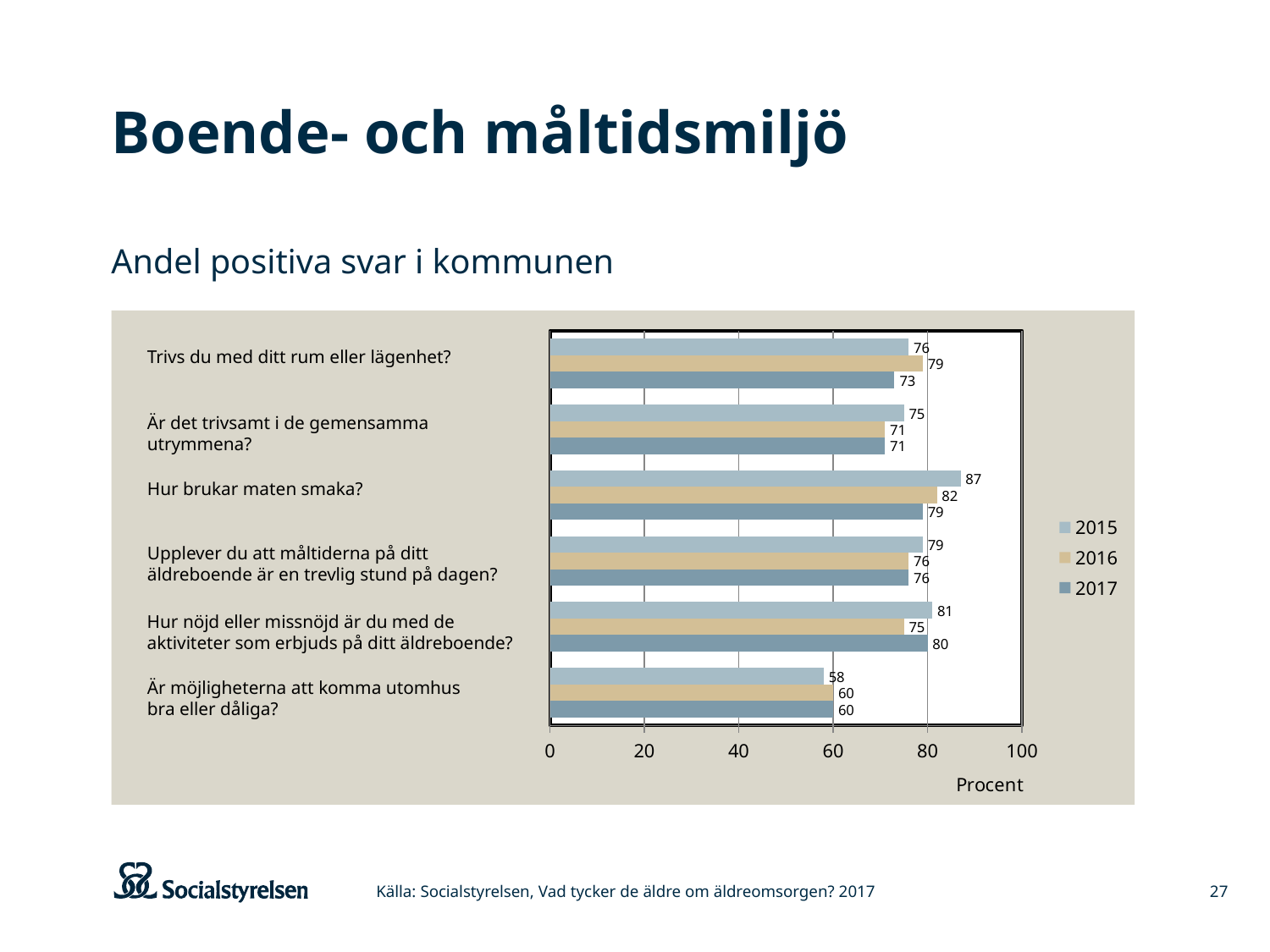
What is the 2015 value for "Är möjligheterna att komma utomhus bra eller dåliga?"? 58 How many questions (categories) are shown in the chart? 6 What kind of chart is shown on the slide? bar chart What is the 2016 value for "Trivs du med ditt rum eller lägenhet?"? 79 For "Hur nöjd eller missnöjd är du med de aktiviteter som erbjuds på ditt äldreboende?", which year has the larger value, 2016 or 2017? 2017 How many series does the legend list? 3 What label is shown on the horizontal axis of the chart? Procent What is the 2017 value for "Hur brukar maten smaka?"? 79 Is the 2016 value for "Är möjligheterna att komma utomhus bra eller dåliga?" greater or less than 80? less Which question has the highest 2015 value? Hur brukar maten smaka? What is the difference between the 2015 and 2017 values for "Hur brukar maten smaka?"? 8 Which question has the lowest 2017 value? Är möjligheterna att komma utomhus bra eller dåliga?